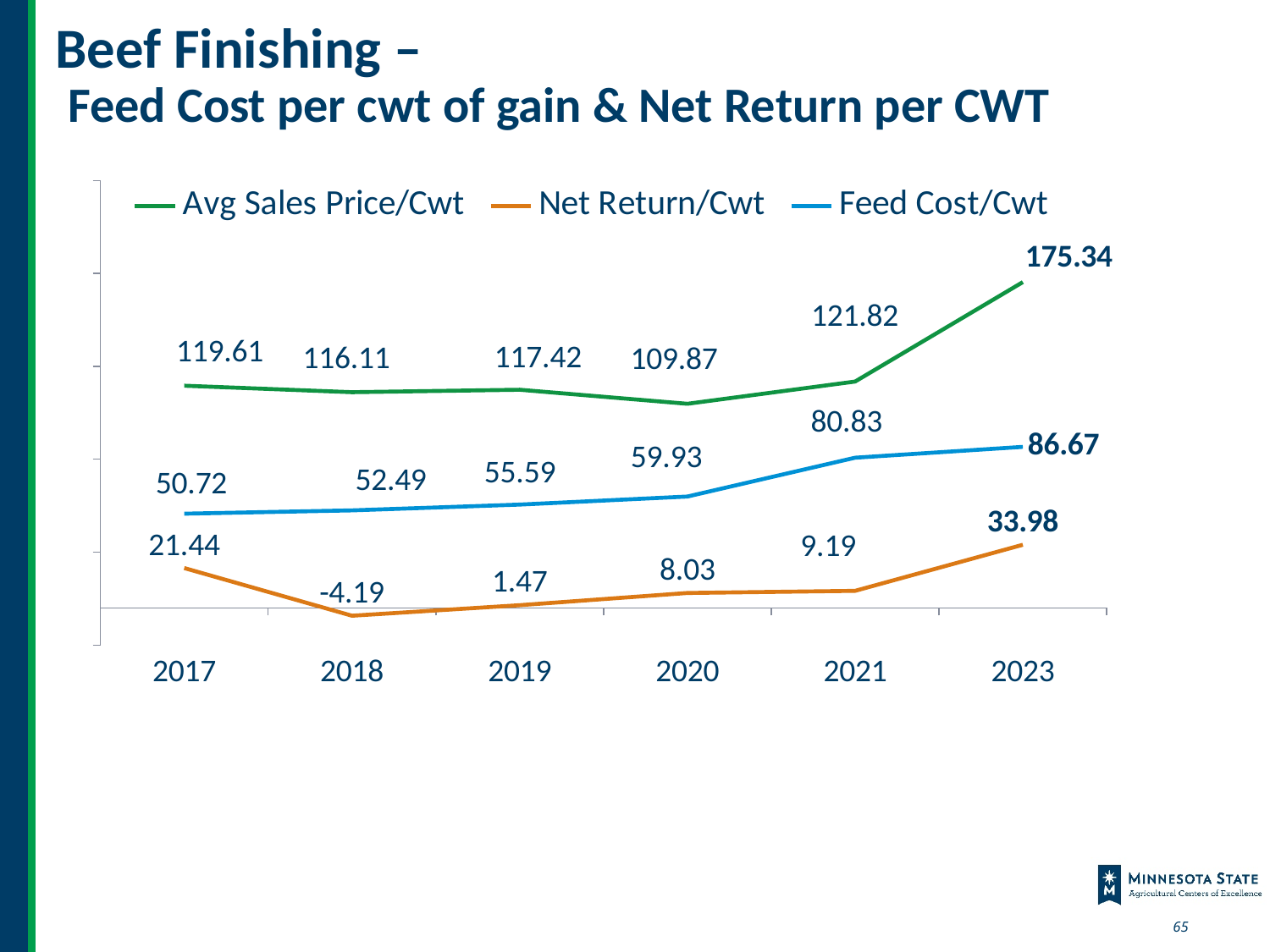
What is the Feed Cost/Cwt value for 2021? 80.83 How many series does the legend list? 3 In which year is Feed Cost/Cwt the lowest? 2017 Does Feed Cost/Cwt rise or fall from 2017 to 2023? Rise In which year is Avg Sales Price/Cwt the highest? 2023 Which is larger, the Avg Sales Price/Cwt for 2019 or for 2020? 2019 What is the Avg Sales Price/Cwt value for 2023? 175.34 What is the Net Return/Cwt value for 2018? -4.19 In which year is Net Return/Cwt the lowest? 2018 How many years are shown on the x axis? 6 What kind of chart is shown on the slide? Line chart What is the difference between the Feed Cost/Cwt values for 2023 and 2017? 35.95